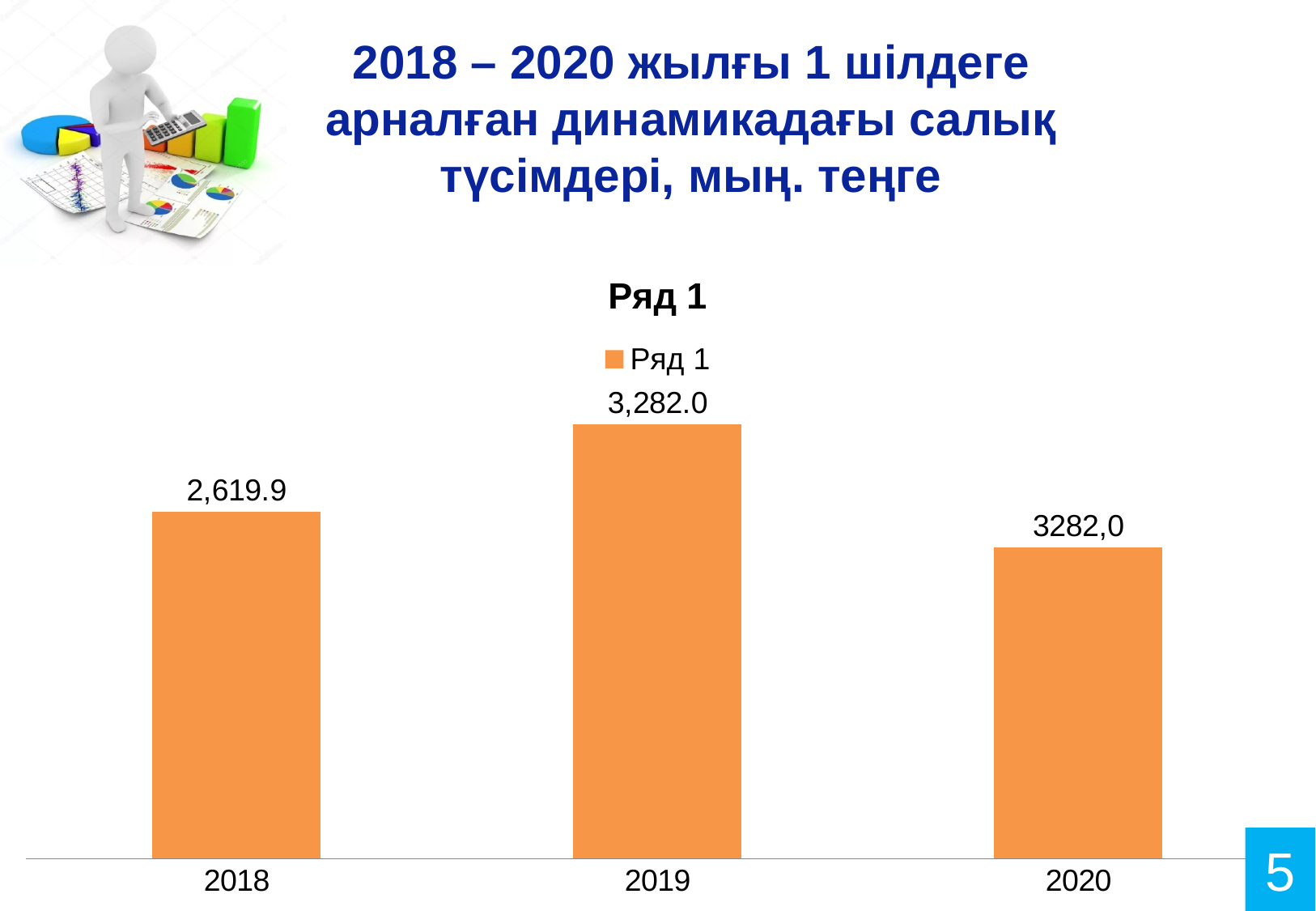
Which year has the lowest value? 2020 What kind of chart is shown on the slide? bar chart How many series does the legend list? 1 What is the value for 2019? 3,282.0 What is the difference between the values for 2019 and 2018? 662.1 What is the data label shown above the 2020 bar? 3282,0 What is the value for 2018? 2,619.9 Which is larger, the value for 2018 or the value for 2019? 2019 What colour are the bars in the chart? orange How many years are shown on the x axis? 3 What is the name of the series in the legend? Ряд 1